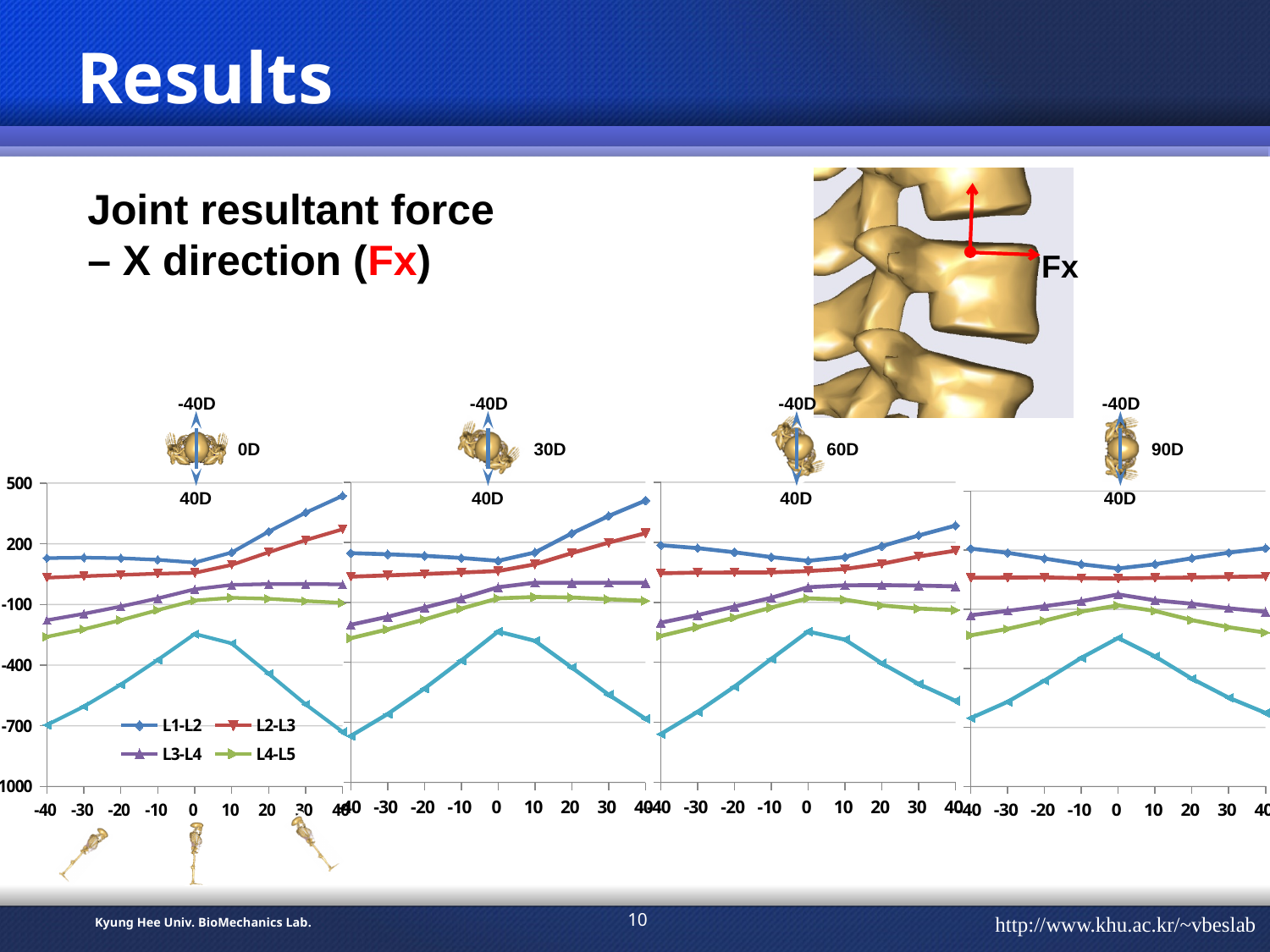
In the 0D chart, does the L1-L2 line rise or fall from x = 0 to x = 40? rise In the 0D chart, is the value of L1-L2 at x = 40 greater or less than 200? greater In the 0D chart, how many x-axis points does each series have? 9 In the 0D chart, at x = 40, which is larger: L1-L2 or L2-L3? L1-L2 In the 0D chart, is the value of L4-L5 at x = -40 greater or less than -100? less In the 90D chart, is the value of L1-L2 at x = 0 greater or less than 200? less How many line charts are shown on the slide? 4 In the 0D chart, which legend series has the highest value at x = 40? L1-L2 In the 0D chart, at x = -40, which is larger: L3-L4 or L4-L5? L3-L4 What is the title of the results shown on the slide? Joint resultant force – X direction (Fx) What kind of chart is used for the 0D panel? line chart How many series does the legend in the 0D chart list? 4